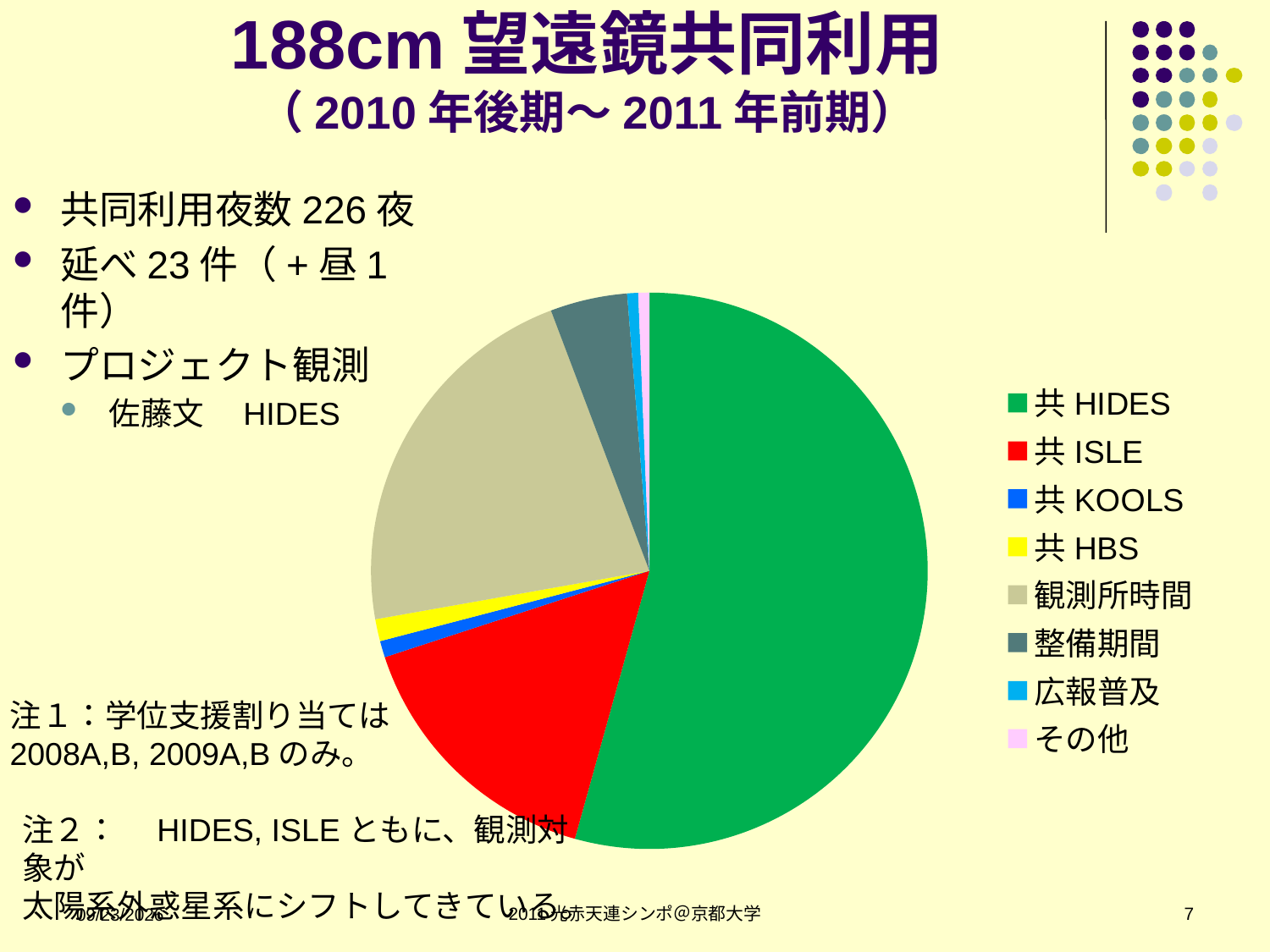
Which slice is larger, 共 HIDES or 共 ISLE? 共 HIDES Which slice is larger, 観測所時間 or 共 HBS? 観測所時間 Which category has the largest slice of the pie chart? 共 HIDES Which slice is larger, 共 ISLE or 共 KOOLS? 共 ISLE Is the share of 共 HIDES in the pie chart greater or less than 50%? greater Which category is shown in red in the pie chart? 共 ISLE What kind of chart is shown on the slide? pie chart Which colour represents 共 HIDES in the pie chart? green How many categories does the legend of the pie chart list? 8